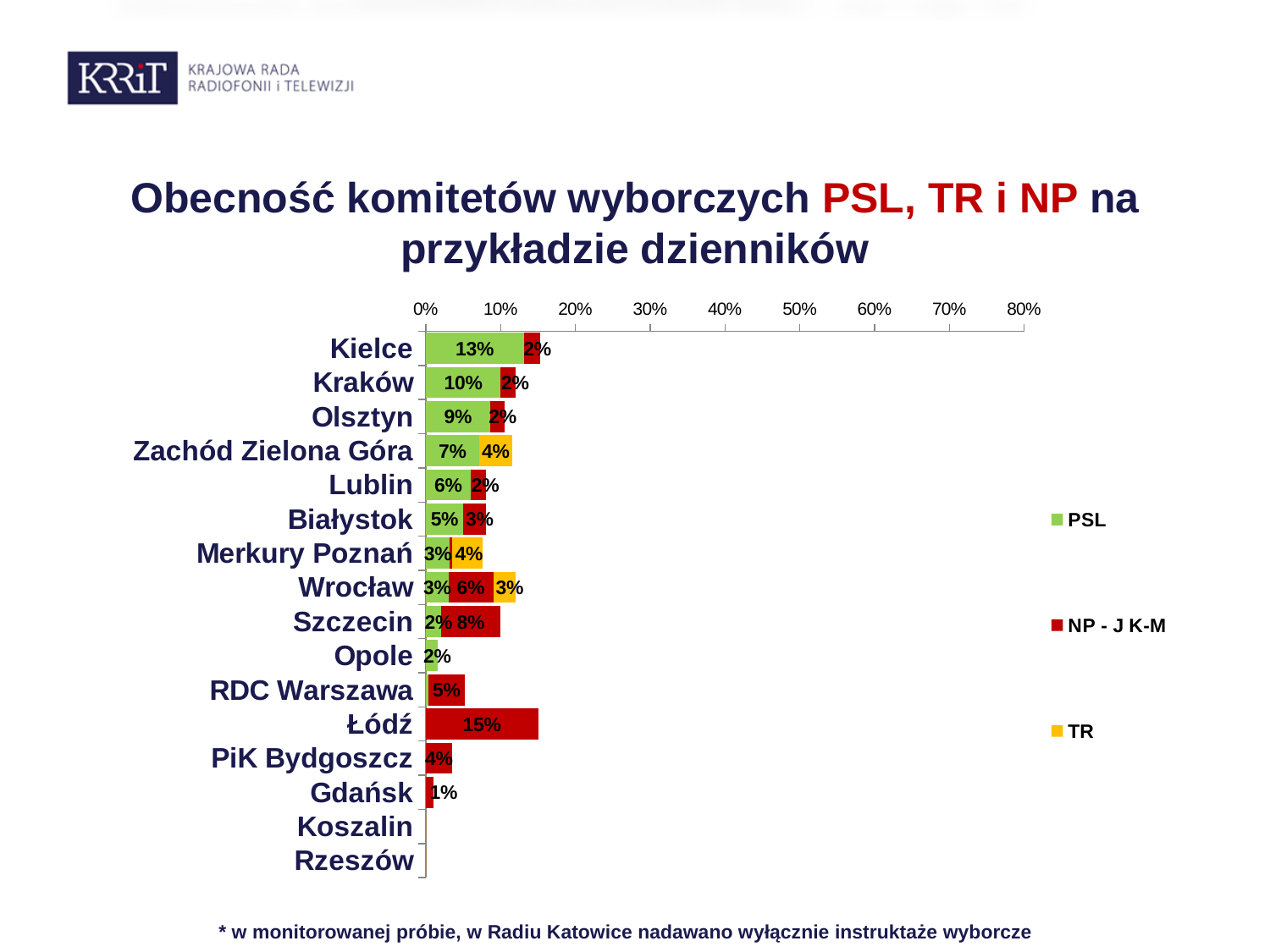
What kind of chart is shown on the slide? Stacked bar chart Which station has the highest PSL value? Kielce Which station has the highest NP - J K-M value? Łódź What is the PSL value for Kielce? 13% How many series does the legend list? 3 What is the TR value for Zachód Zielona Góra? 4% Which is larger, the NP - J K-M value for Szczecin or for RDC Warszawa? Szczecin What is the total of the stacked bar for Wrocław? 12% How many stations are listed on the vertical axis of the chart? 16 What is the NP - J K-M value for Łódź? 15% What is the difference between the PSL values for Kielce and Kraków? 3% Which series is shown in yellow in the legend? TR